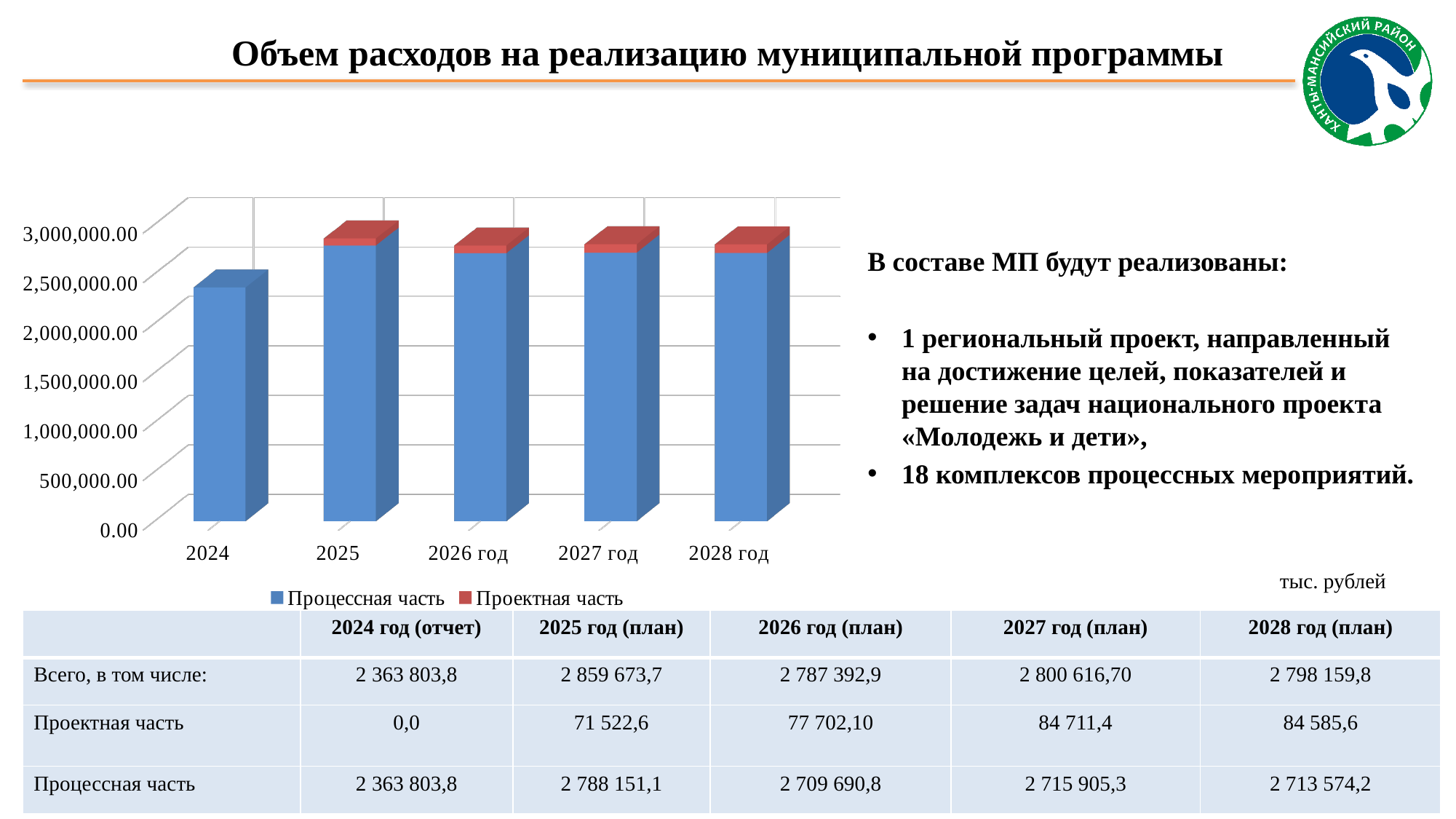
Which year has the highest total expenditure according to the slide? 2025 How many series does the chart legend list? 2 How many year categories are plotted on the x axis of the chart? 5 Is the total bar for 2024 greater or less than 2,500,000.00? less Does the total expenditure rise or fall from 2024 to 2025? rise What is the total (Всего) for 2028 год (план)? 2 798 159,8 What is the value of Процессная часть for 2024 год (отчет)? 2 363 803,8 Is the total bar for 2025 greater or less than 2,500,000.00? greater Which year has the lowest total bar in the chart? 2024 What is the value of Проектная часть for 2027 год (план)? 84 711,4 What kind of chart is shown on the slide? Stacked bar chart Which is larger, Процессная часть in 2025 or in 2026? 2025